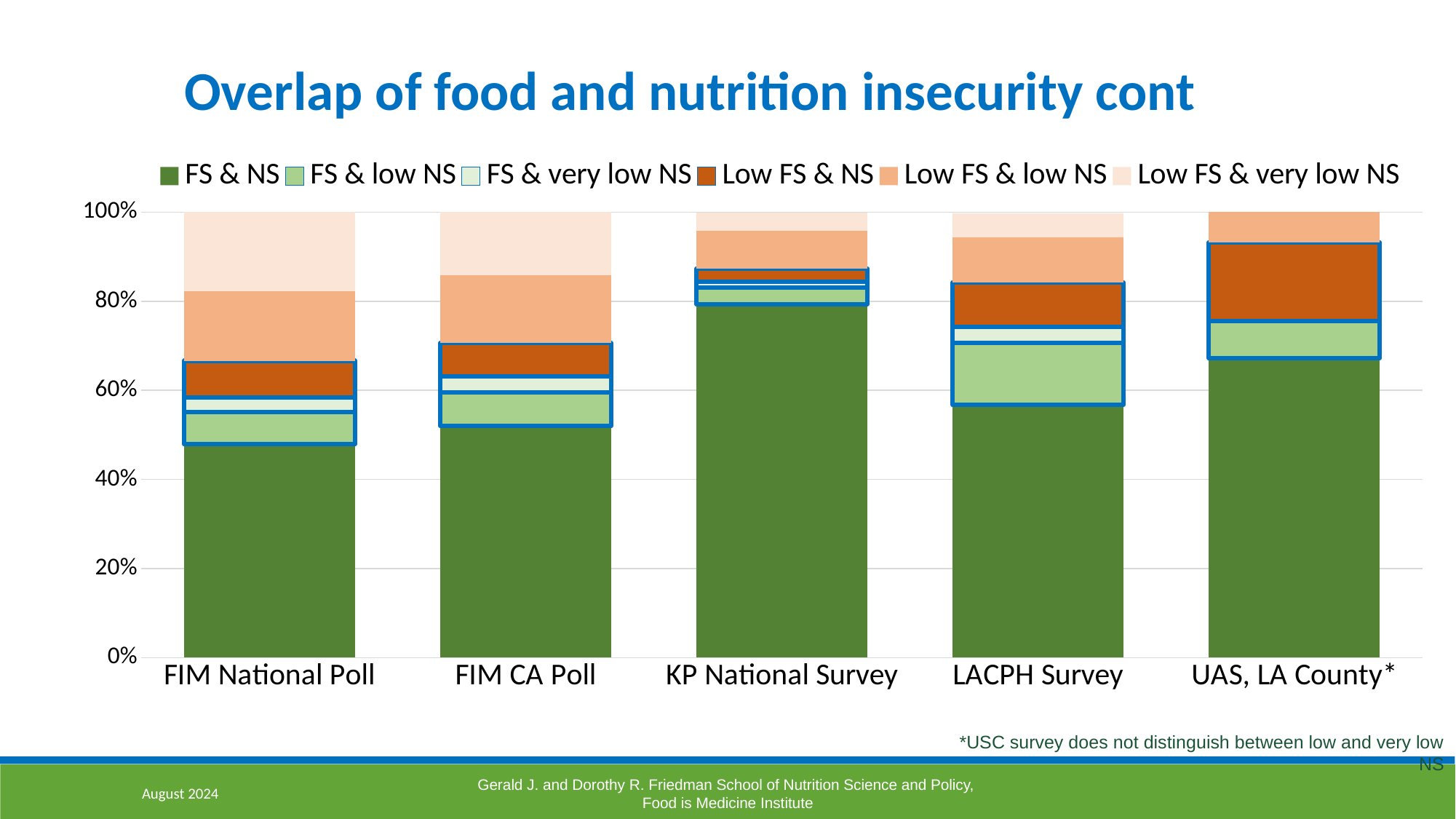
What is the total of the stacked bar for FIM National Poll? 100% Is the FS & NS value for UAS, LA County* greater or less than 60%? greater How many series does the legend list? 6 Is the FS & NS value for FIM National Poll greater or less than 60%? less Which survey has the highest share of FS & NS (the dark green segment)? KP National Survey How many surveys (categories) are shown on the x axis? 5 Is the FS & NS value for KP National Survey greater or less than 60%? greater What is the title of the chart? Overlap of food and nutrition insecurity cont Which has a larger FS & NS share, KP National Survey or UAS, LA County*? KP National Survey Which has a larger Low FS & very low NS share, FIM National Poll or KP National Survey? FIM National Poll What type of chart is shown on the slide? Stacked bar chart